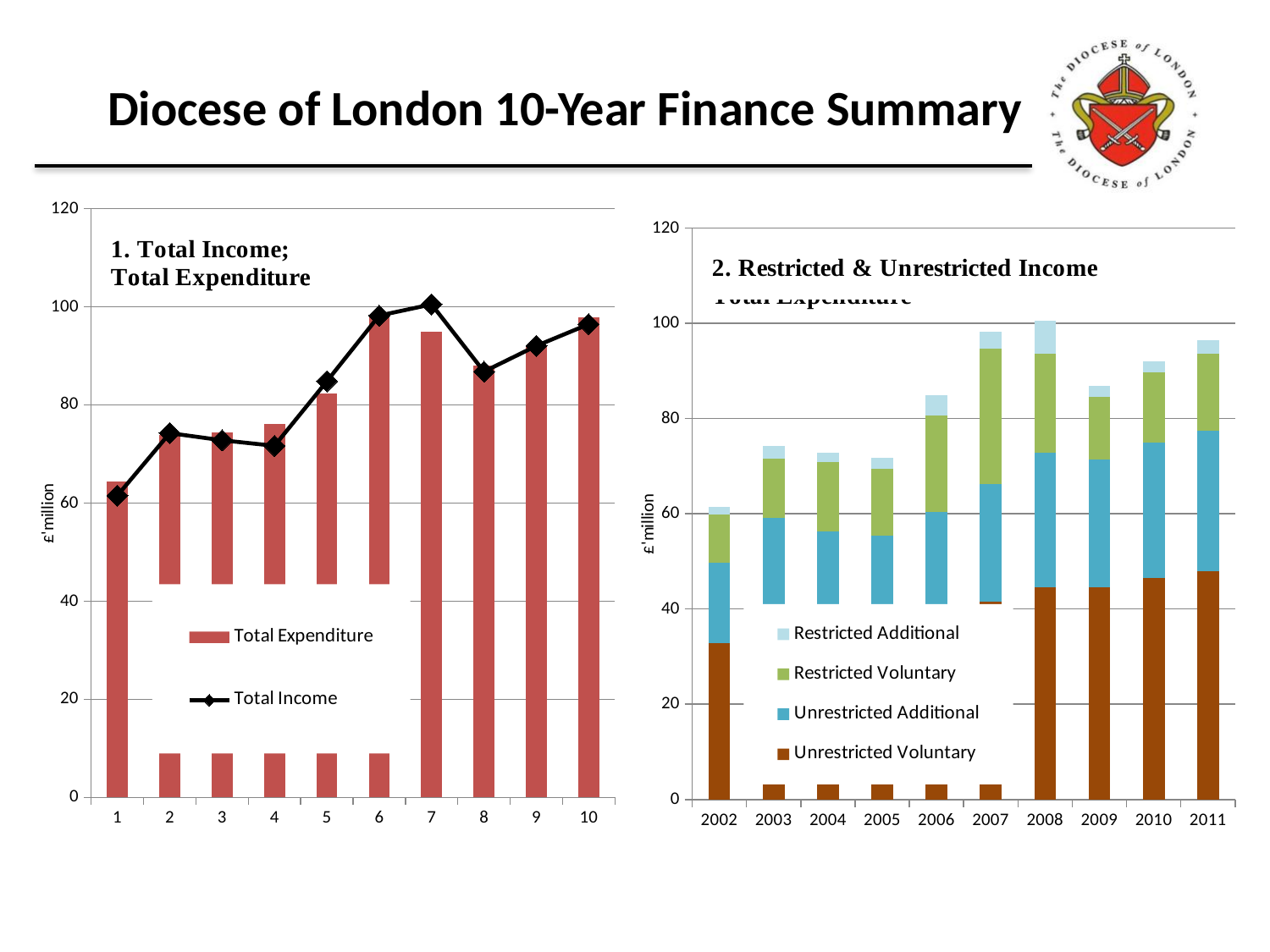
In the chart titled '2. Restricted & Unrestricted Income', is the Unrestricted Voluntary value for 2011 greater or less than 40? greater In the chart titled '1. Total Income; Total Expenditure', which category has the lowest Total Income? 1 In the chart titled '2. Restricted & Unrestricted Income', how many series does the legend list? 4 In the chart titled '1. Total Income; Total Expenditure', what is the unit shown on the y axis? £'million In the chart titled '1. Total Income; Total Expenditure', is the Total Income for category 6 greater or less than 80? greater In the chart titled '1. Total Income; Total Expenditure', which is larger, the Total Income for category 1 or for category 6? category 6 In the chart titled '1. Total Income; Total Expenditure', how many categories are shown on the x axis? 10 In the chart titled '2. Restricted & Unrestricted Income', is the total stacked bar for 2007 greater or less than 80? greater In the chart titled '2. Restricted & Unrestricted Income', which year has the lowest total stacked bar? 2002 In the chart titled '1. Total Income; Total Expenditure', how many series does the legend list? 2 In the chart titled '2. Restricted & Unrestricted Income', how many years are shown on the x axis? 10